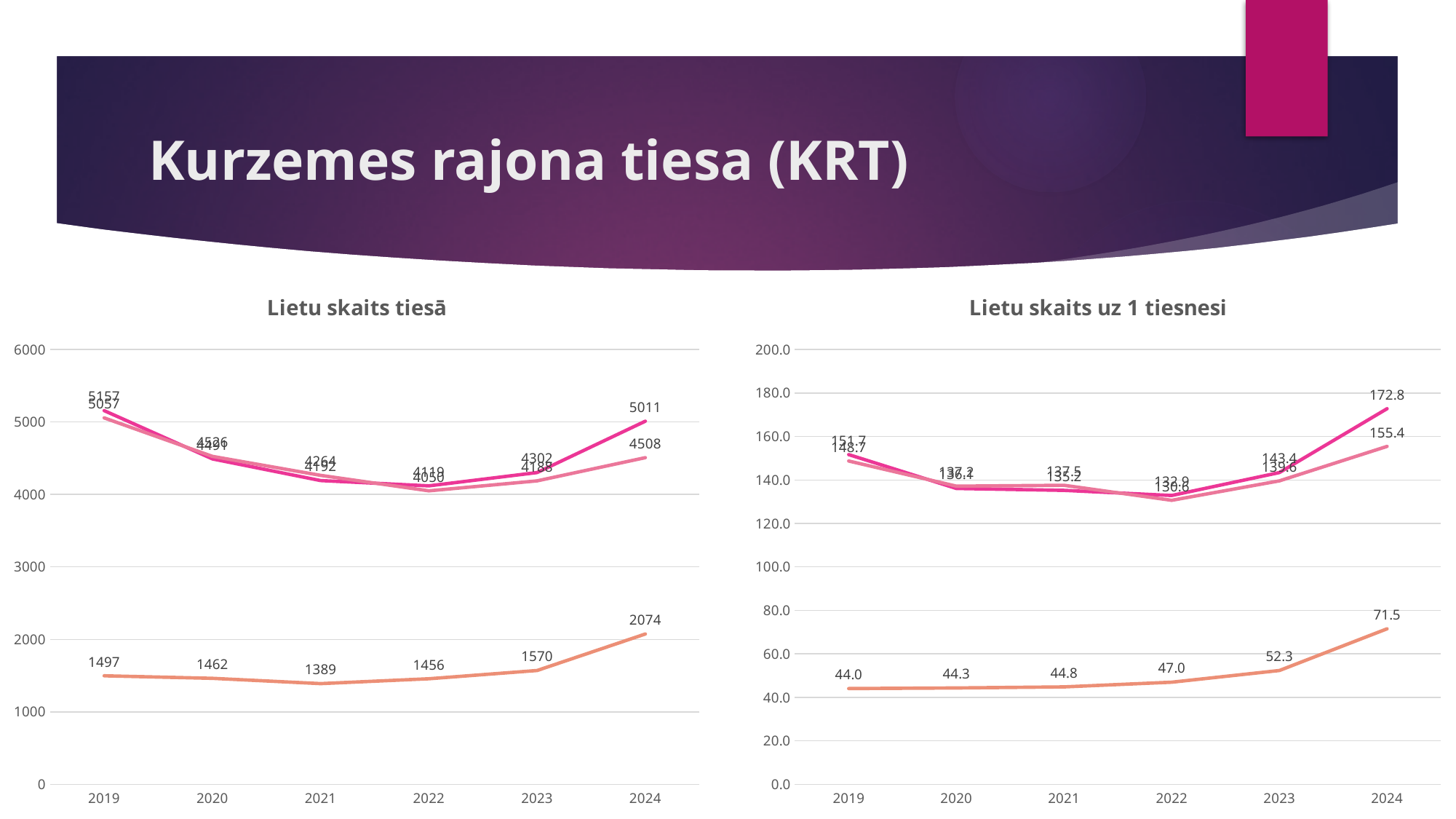
In the chart titled "Lietu skaits uz 1 tiesnesi", what is the value of the orange line for 2023? 52.3 In the chart titled "Lietu skaits uz 1 tiesnesi", does the orange line rise or fall from 2019 to 2024? rise In the chart titled "Lietu skaits tiesā", what is the value of the orange line for 2021? 1389 How many years are shown on the x axis of the chart titled "Lietu skaits tiesā"? 6 In the chart titled "Lietu skaits tiesā", in which year is the orange line at its lowest? 2021 In the chart titled "Lietu skaits uz 1 tiesnesi", what is the difference between the orange line's 2024 value and its 2019 value? 27.5 In the chart titled "Lietu skaits tiesā", what is the difference between the orange line's 2024 value and its 2023 value? 504 In the chart titled "Lietu skaits uz 1 tiesnesi", which is larger for 2024: the top magenta line's value of 172.8 or the lower pink line's value of 155.4? 172.8 In the chart titled "Lietu skaits tiesā", what is the value of the orange line for 2024? 2074 In the chart titled "Lietu skaits tiesā", is the orange line's value for 2022 greater or less than 2000? less In the chart titled "Lietu skaits uz 1 tiesnesi", what is the highest value of the orange line, and in which year? 71.5 in 2024 What kind of chart is "Lietu skaits uz 1 tiesnesi"? line chart